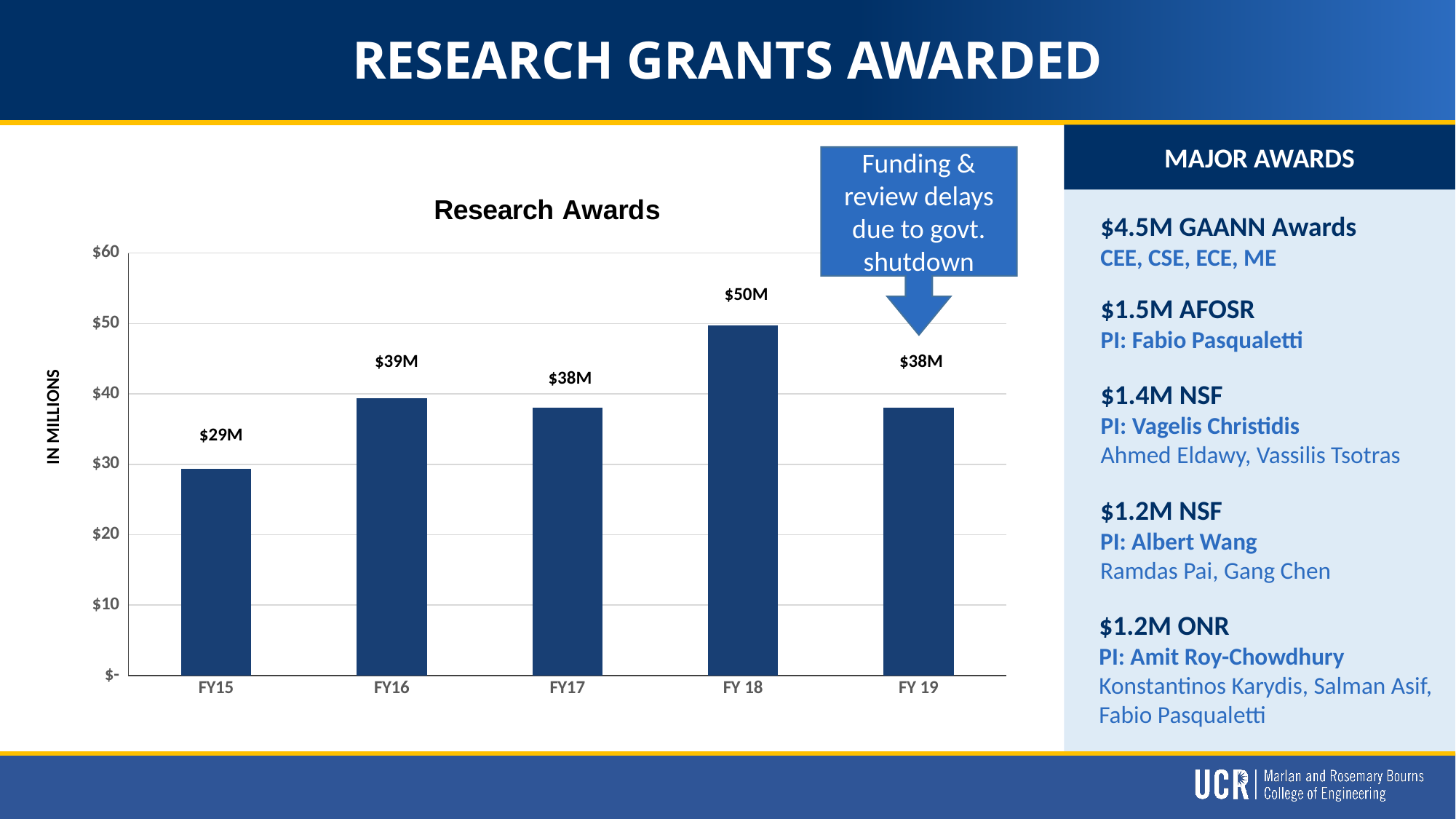
What kind of chart is the Research Awards chart? bar chart What is the label on the vertical axis of the Research Awards chart? IN MILLIONS Is the value for FY17 greater or less than $30? greater How many fiscal years are shown in the Research Awards chart? 5 What is the value for FY 19 in the Research Awards chart? $38M What is the value for FY15 in the Research Awards chart? $29M What is the difference between the FY16 and FY15 values? $10M Which fiscal year has the lowest research awards value? FY15 Which fiscal year has the highest research awards value? FY 18 Which is larger, the value for FY16 or the value for FY15? FY16 What is the value for FY 18 in the Research Awards chart? $50M What is the difference between the FY 18 and FY 19 values? $12M